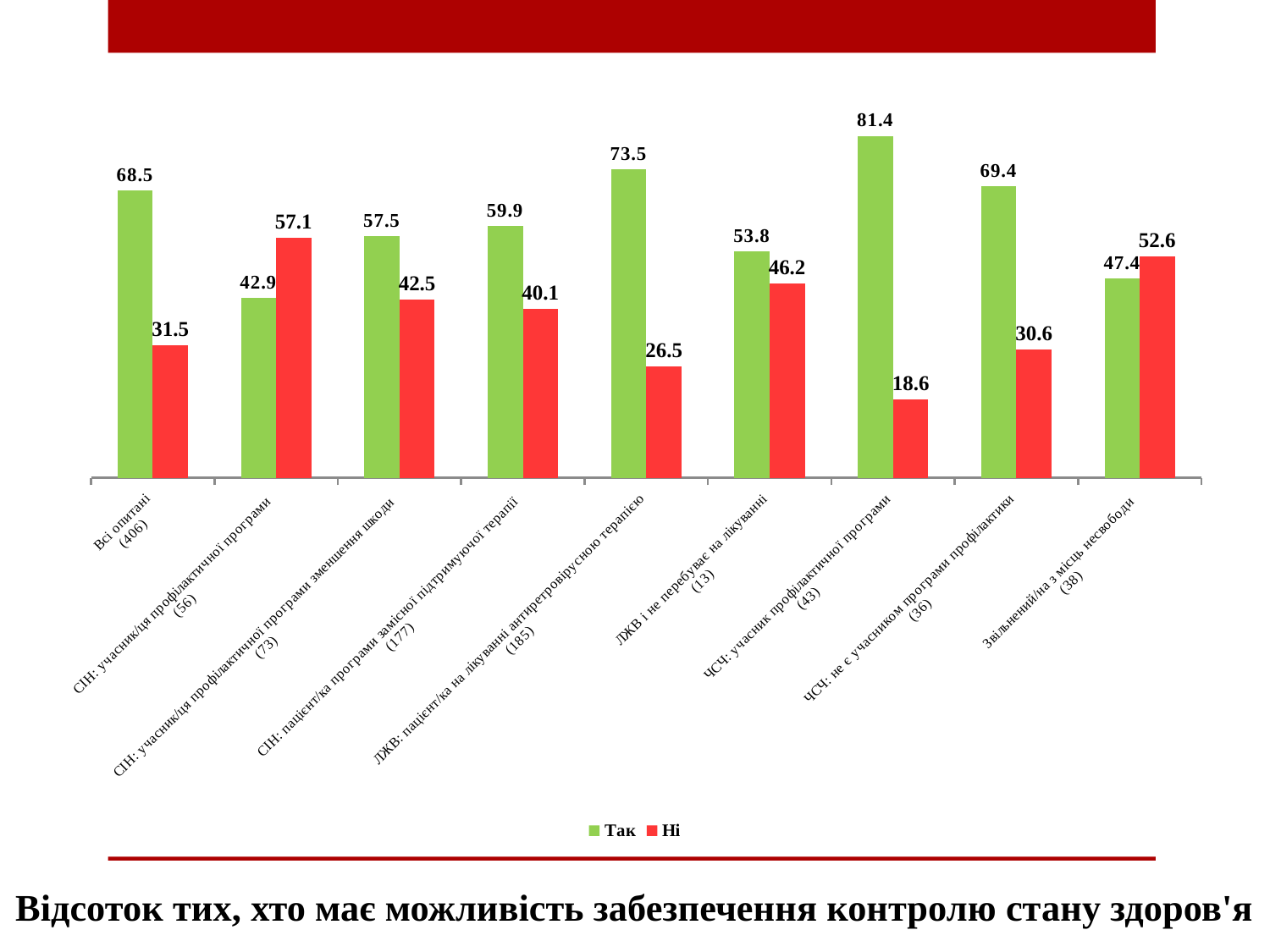
What is the 'Ні' value for 'ЧСЧ: учасник профілактичної програми (43)'? 18.6 What is the 'Так' value for 'Звільнений/на з місць несвободи (38)'? 47.4 Which is larger for 'СІН: учасник/ця профілактичної програми (56)': the 'Так' value or the 'Ні' value? Ні Which category has the lowest 'Так' value? СІН: учасник/ця профілактичної програми (56) What kind of chart is shown on the slide? Bar chart Which category has the lowest 'Ні' value? ЧСЧ: учасник профілактичної програми (43) How many series does the legend list? 2 What is the 'Так' value for 'Всі опитані (406)'? 68.5 How many categories are shown on the x axis? 9 What is the difference between the 'Так' and 'Ні' values for 'ЛЖВ: пацієнт/ка на лікуванні антиретровірусною терапією (185)'? 47 Which colour represents the 'Ні' series? Red Which category has the highest 'Так' value? ЧСЧ: учасник профілактичної програми (43)